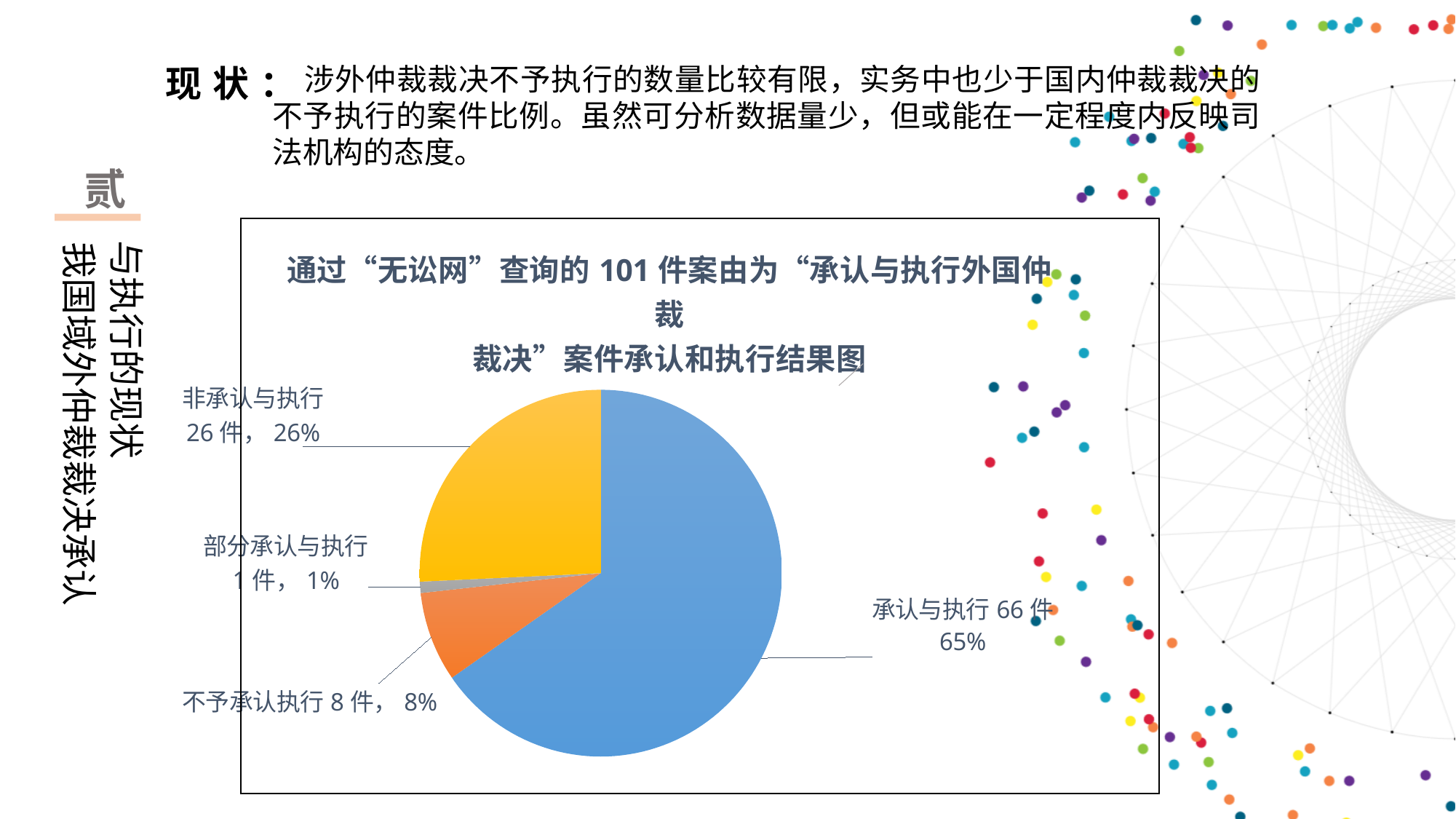
Which category has the smallest slice of the pie? 部分承认与执行 What percentage share does the 非承认与执行 slice have? 26% How many more cases are in 承认与执行 than in 非承认与执行? 40 件 Which category has the largest slice of the pie? 承认与执行 What is the total number of cases across all slices of the pie? 101 件 Which has more cases, 不予承认执行 or 部分承认与执行? 不予承认执行 What percentage share does the 部分承认与执行 slice have? 1% How many cases are in the 承认与执行 slice? 66 件 What kind of chart is shown on the slide? pie chart What colour is the 承认与执行 slice? blue How many cases are in the 不予承认执行 slice? 8 件 How many slices does the pie chart have? 4